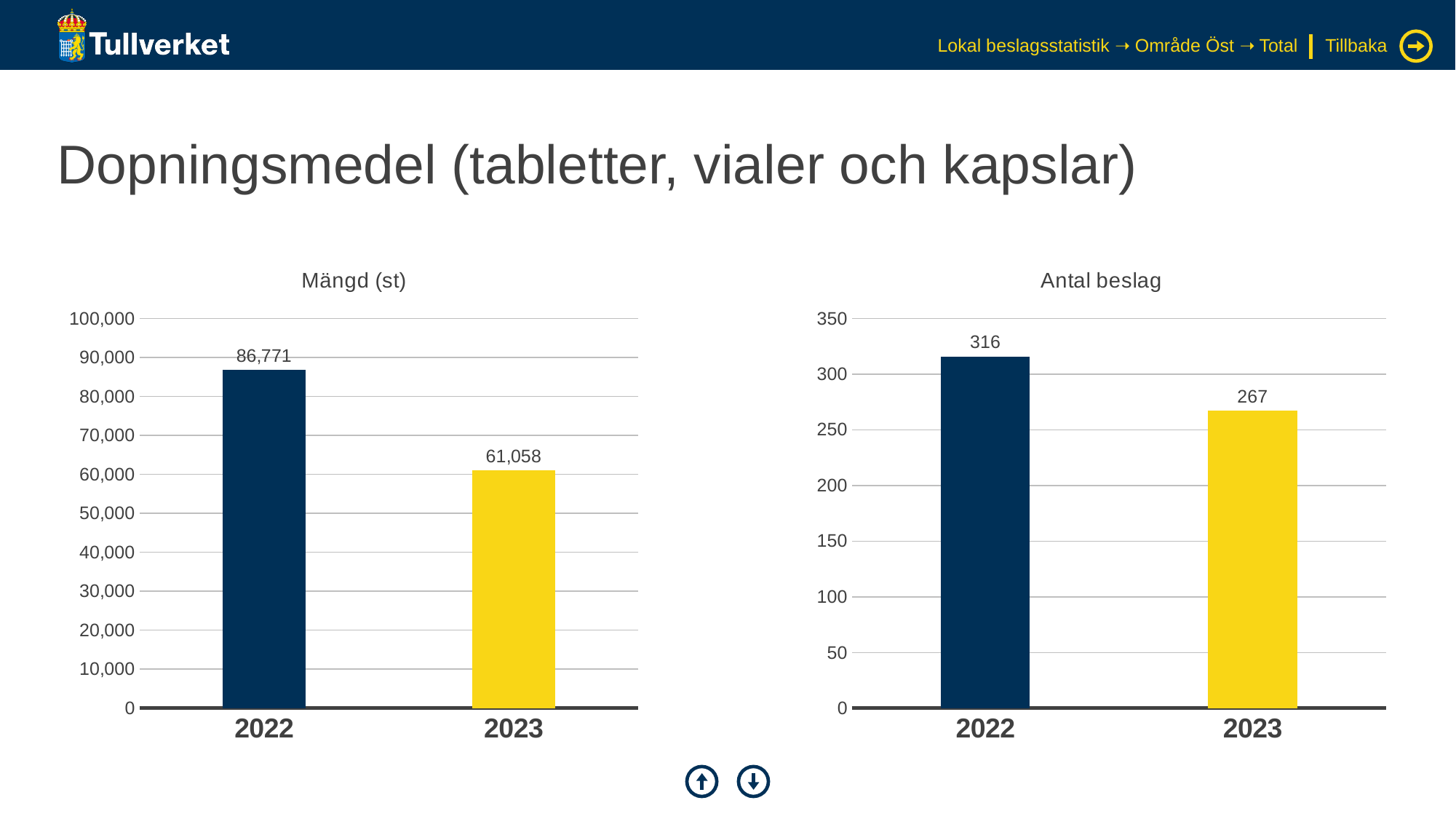
In the 'Antal beslag' chart, what is the value for 2023? 267 In the 'Antal beslag' chart, which year has the lowest value? 2023 In the 'Mängd (st)' chart, what is the value for 2023? 61,058 In the 'Mängd (st)' chart, how many years are shown on the x axis? 2 In the 'Mängd (st)' chart, what is the value for 2022? 86,771 In the 'Mängd (st)' chart, do the values rise or fall from 2022 to 2023? fall In the 'Antal beslag' chart, is the value for 2022 greater or less than 300? greater What kind of chart is the 'Antal beslag' chart? bar chart In the 'Antal beslag' chart, what is the difference between the 2022 and 2023 values? 49 In the 'Antal beslag' chart, what is the value for 2022? 316 In the 'Mängd (st)' chart, what is the difference between the 2022 and 2023 values? 25,713 In the 'Mängd (st)' chart, which year has the highest value? 2022